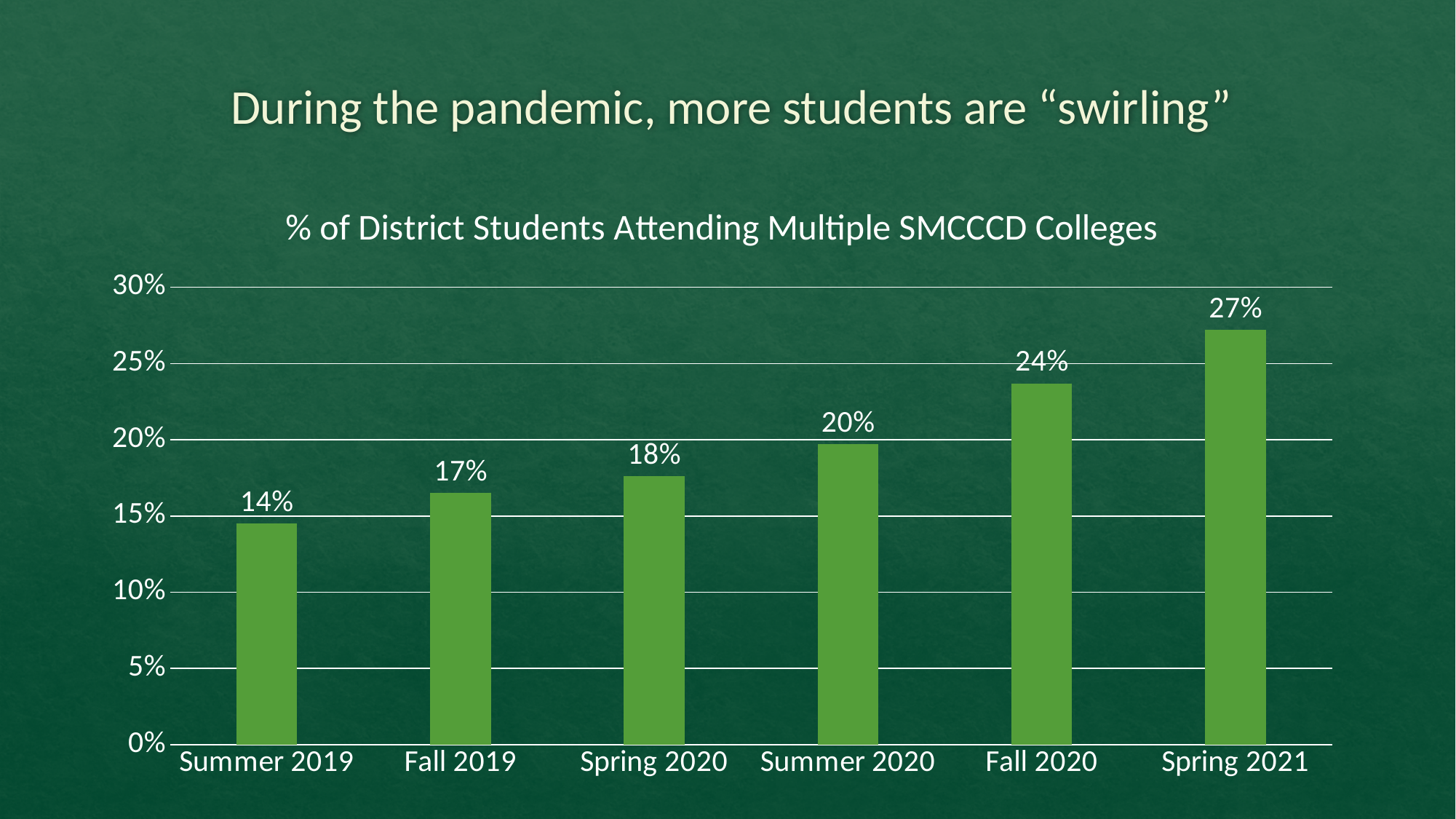
Which is larger, the value for Fall 2019 or the value for Summer 2020? Summer 2020 What is the difference between the values for Fall 2020 and Summer 2020? 4% Which term has the highest percentage of district students attending multiple SMCCCD colleges? Spring 2021 Do the values rise or fall from Summer 2019 to Spring 2021? rise What is the value for Summer 2019? 14% What is the value for Spring 2020? 18% What kind of chart is shown on the slide? bar chart Is the value for Spring 2021 greater or less than 25%? greater How many terms are shown on the x axis? 6 What is the difference between the values for Spring 2021 and Summer 2019? 13% What is the value for Fall 2020? 24% Which term has the lowest percentage? Summer 2019